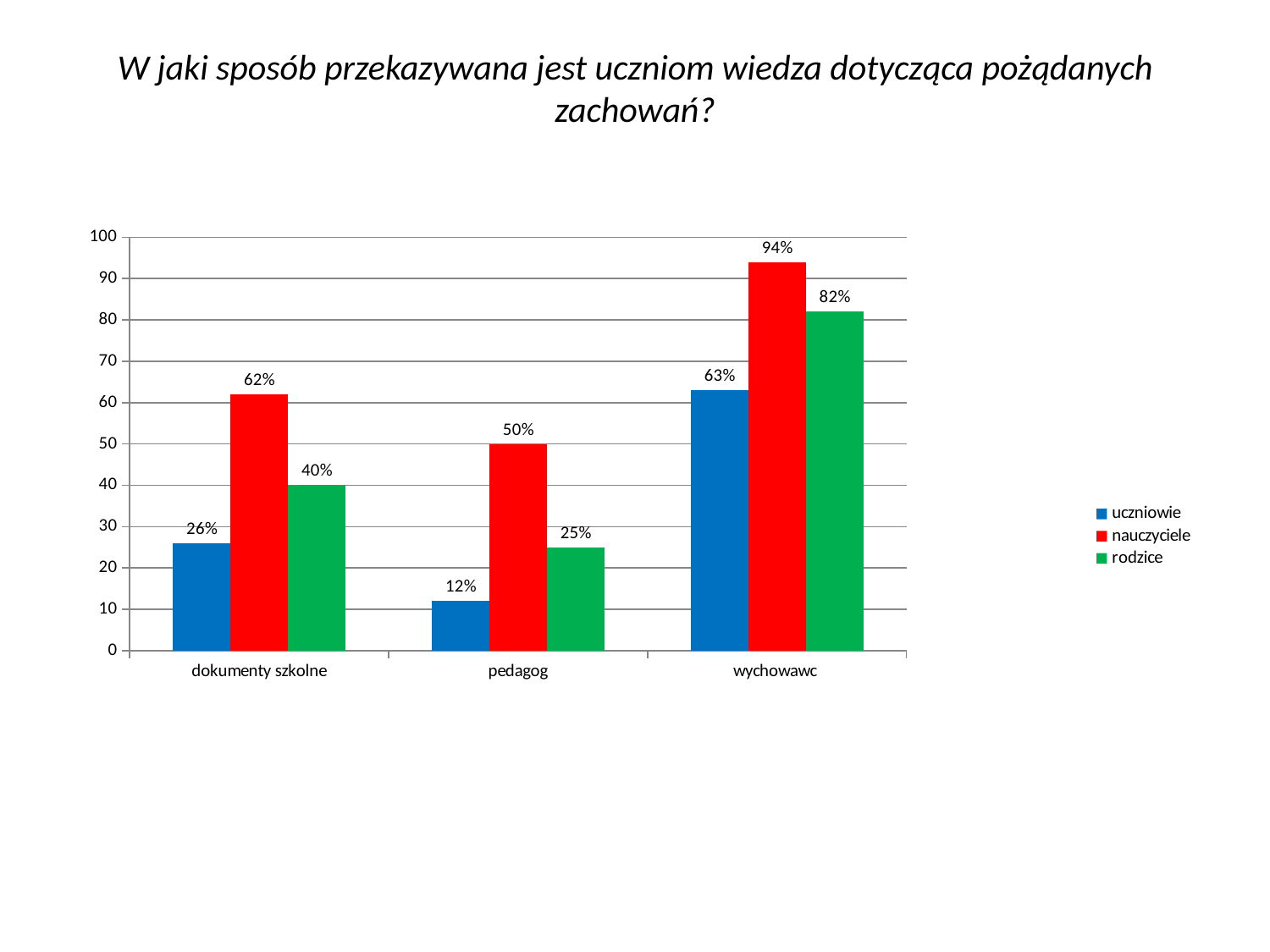
Is the value for rodzice in the dokumenty szkolne category greater or less than 30? greater Which is larger in the pedagog category: the value for nauczyciele or the value for rodzice? nauczyciele What is the value for rodzice in the wychowawc category? 82% How many categories are shown on the x axis? 3 Which colour represents the rodzice series? green What is the value for uczniowie in the pedagog category? 12% Which category has the highest value for the nauczyciele series? wychowawc What is the value for nauczyciele in the dokumenty szkolne category? 62% Which category has the lowest value for the uczniowie series? pedagog What is the difference between the nauczyciele and uczniowie values in the wychowawc category? 31% How many series does the legend list? 3 What kind of chart is shown on the slide? bar chart